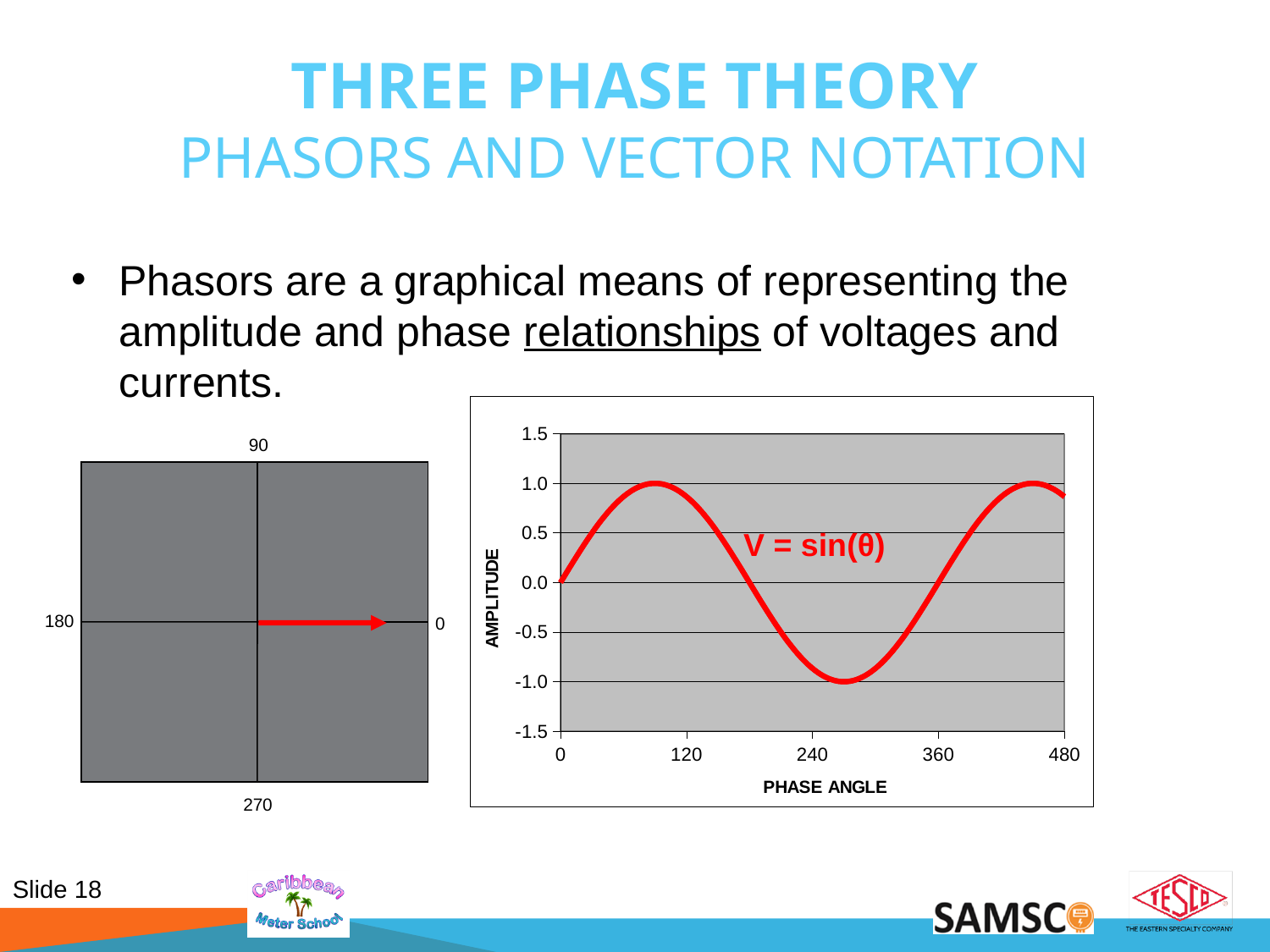
What is the amplitude of the curve at a phase angle of 360? 0.0 Does the curve rise or fall between phase angles 120 and 240? fall What is the highest amplitude value the curve reaches? 1.0 How many tick labels are shown on the x axis of the line chart? 5 Is the amplitude at a phase angle of 120 greater or less than 0.5? greater Is the amplitude at a phase angle of 240 greater or less than -0.5? less What kind of chart is shown on the right side of the slide? line chart What is the title of the y axis of the line chart? AMPLITUDE What is the title of the x axis of the line chart? PHASE ANGLE What is the amplitude of the curve at a phase angle of 0? 0.0 What is the lowest amplitude value the curve reaches? -1.0